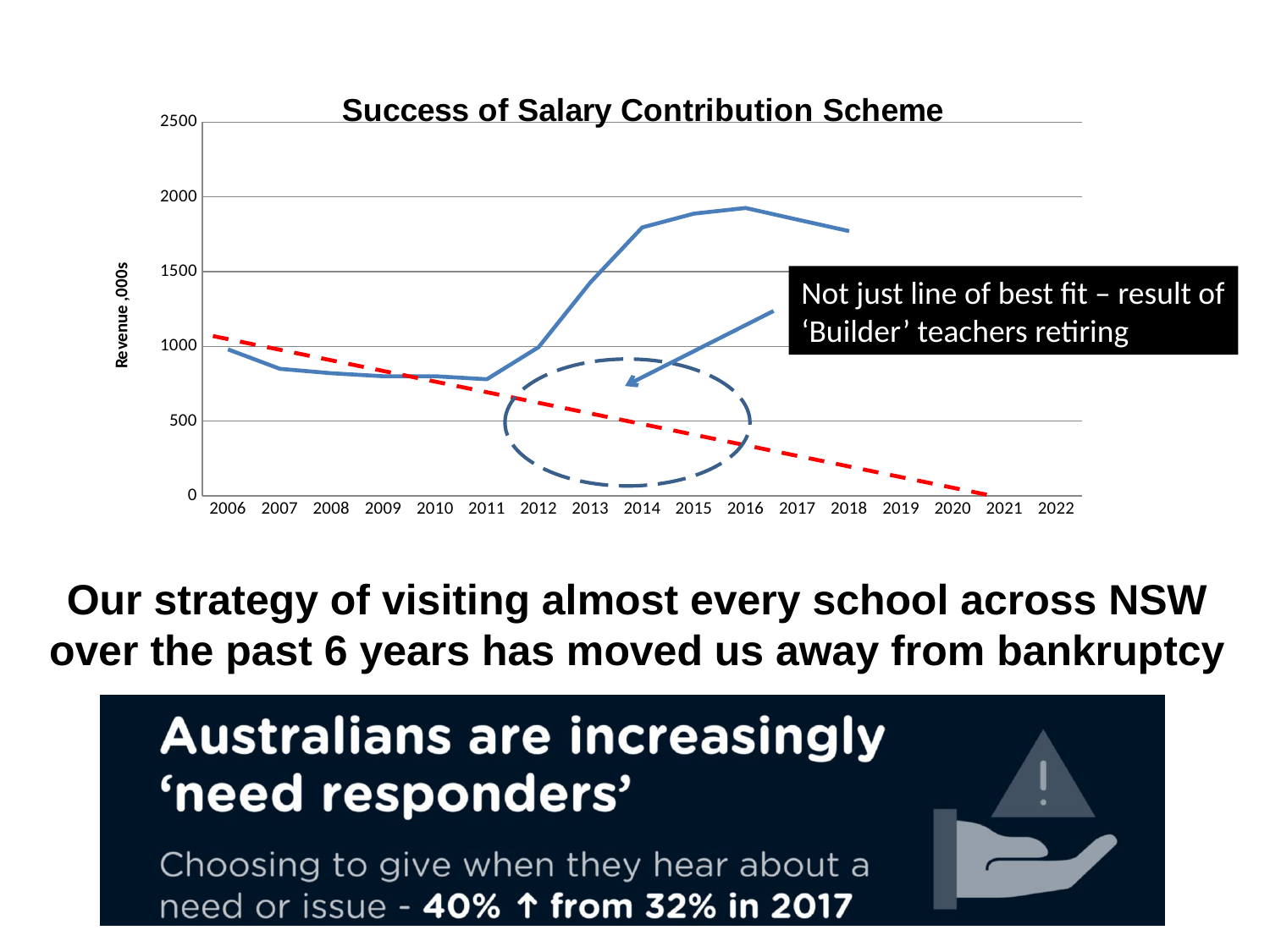
Is the value of the blue line for 2016 greater or less than 1500? greater Which year has the larger value on the blue line, 2011 or 2014? 2014 How many years are labelled on the x axis of the chart? 17 What kind of chart is shown on the slide? line chart Does the blue line rise or fall between 2011 and 2016? rise Is the value of the blue line for 2018 greater or less than 1500? greater What is the label on the vertical axis of the chart? Revenue ,000s Is the value of the blue line for 2014 greater or less than 1500? greater Which year has the larger value on the blue line, 2006 or 2016? 2016 What is the title of the chart? Success of Salary Contribution Scheme